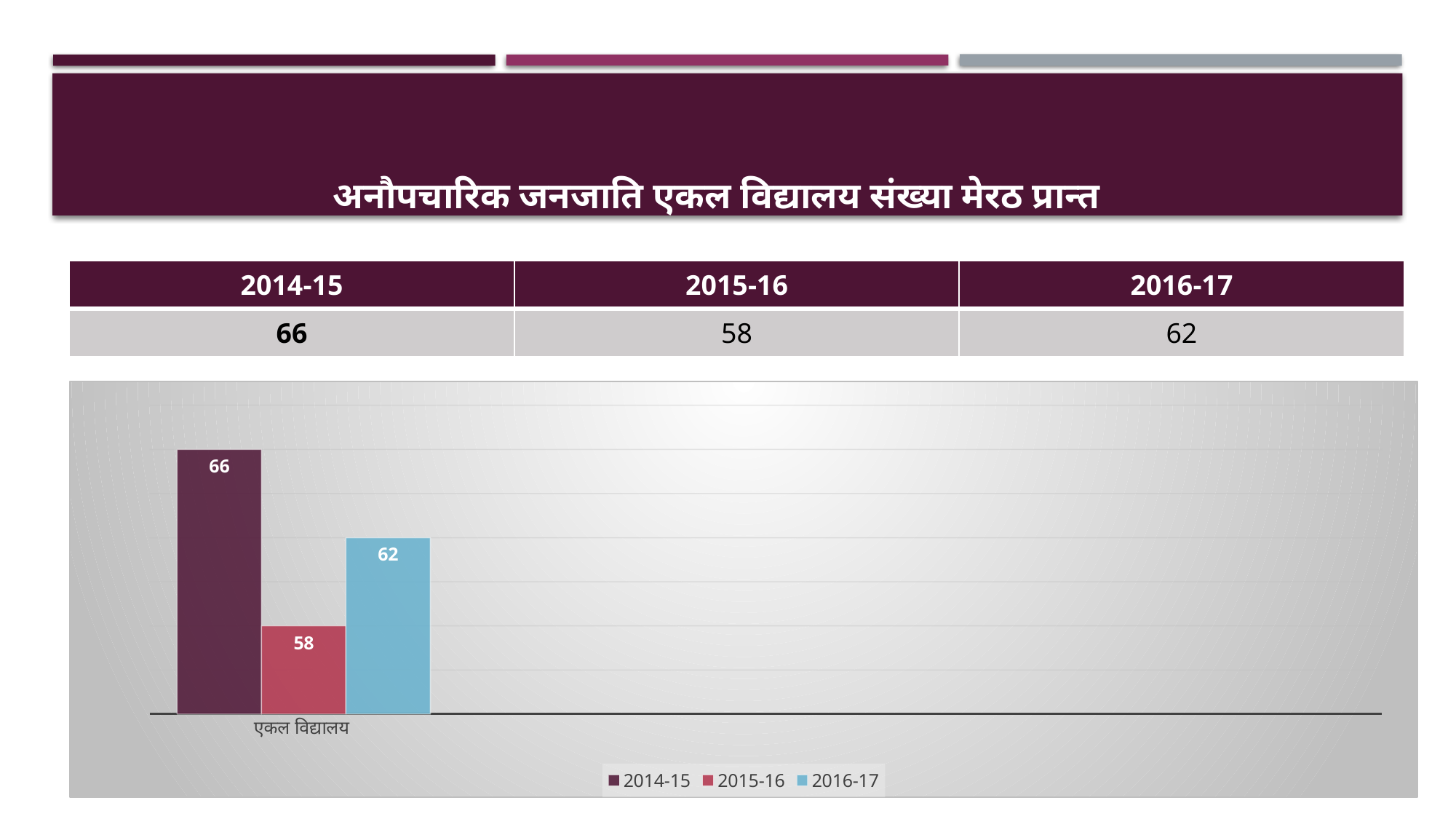
What is the difference between the values for 2016-17 and 2015-16? 4 What is the difference between the values for 2014-15 and 2015-16? 8 Which series has the highest value in the chart? 2014-15 What is the category label shown on the x axis of the chart? एकल विद्यालय Which is larger, the value for 2016-17 or the value for 2015-16? 2016-17 What colour is the bar for 2016-17 in the chart? light blue What kind of chart is shown on the slide? bar chart What is the value for 2014-15 in the chart? 66 What is the value for 2016-17 in the chart? 62 What is the value for 2015-16 in the chart? 58 Which series has the lowest value in the chart? 2015-16 How many series does the legend list? 3